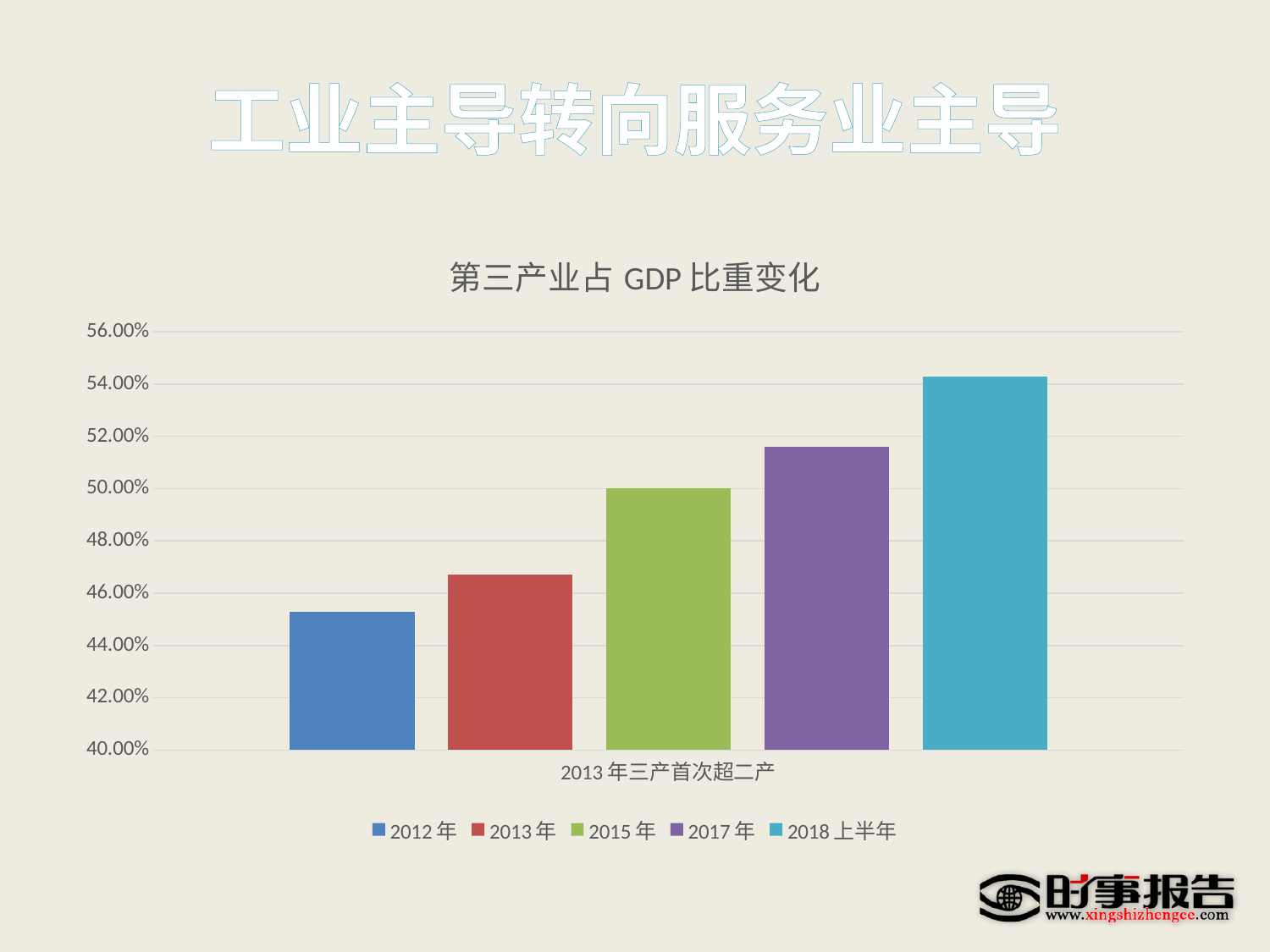
Which is larger, the value for 2017年 or the value for 2013年? 2017年 What is the title of the chart? 第三产业占 GDP 比重变化 Which series has the lowest value? 2012年 Is the value for 2012年 greater or less than 46.00%? less How many series does the legend list? 5 Is the value for 2018上半年 greater or less than 52.00%? greater Do the values rise or fall from 2012年 to 2018上半年 across the bars? rise Is the value for 2017年 greater or less than 50.00%? greater Which series has the highest value? 2018上半年 What kind of chart is shown on the slide? bar chart How many bars are plotted in the chart? 5